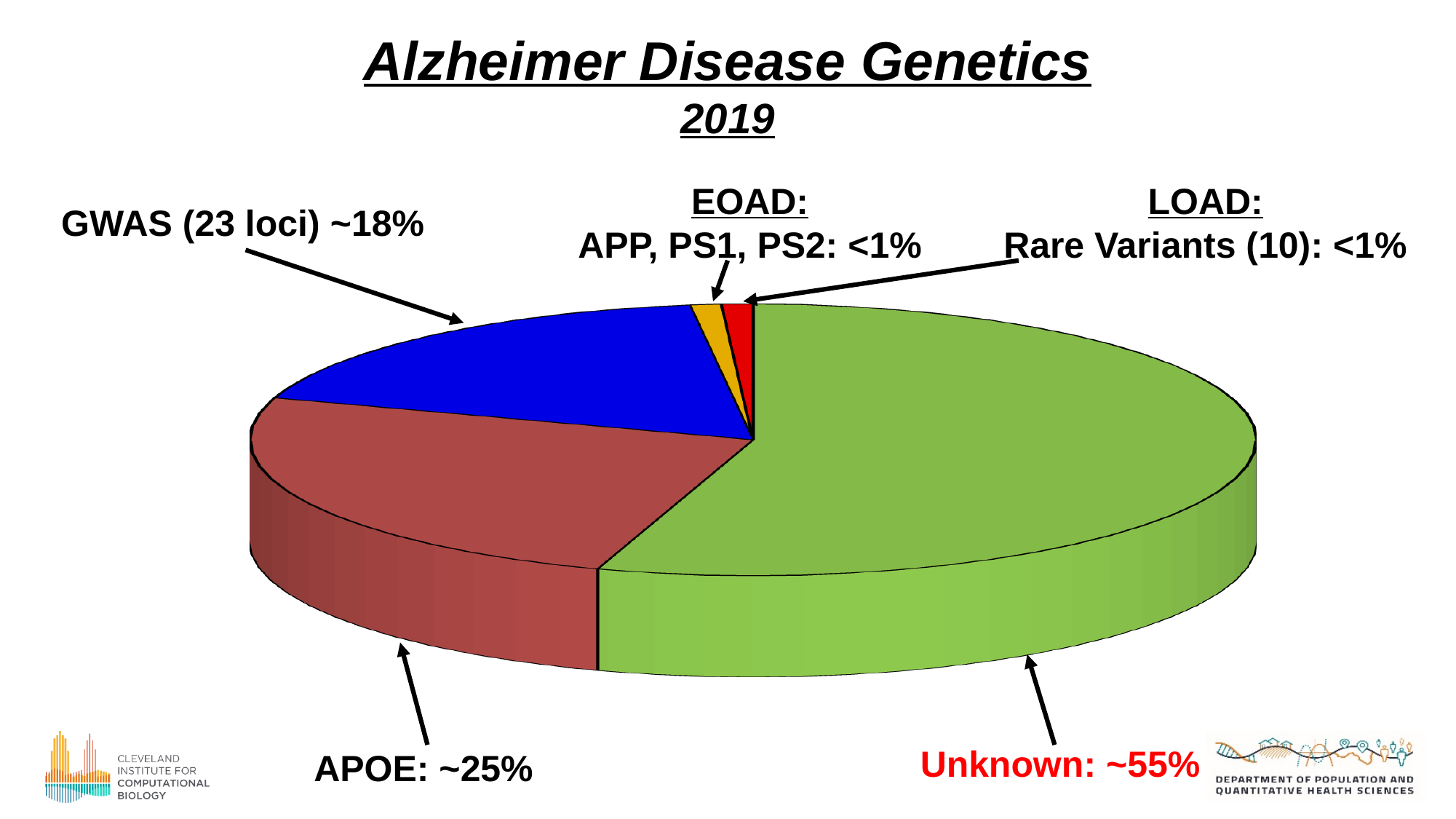
What share is given for EOAD: APP, PS1, PS2? <1% Which slice of the pie is the largest? Unknown What share of the pie is labelled for APOE? ~25% What share is given for LOAD: Rare Variants (10)? <1% What colour is the Unknown slice of the pie? green What share of the pie is labelled for Unknown? ~55% Which is larger, the Unknown slice or the APOE slice? Unknown What is the title of the slide containing the pie chart? Alzheimer Disease Genetics 2019 How many slices does the pie chart have? 5 What kind of chart is shown on the slide? pie chart Which is larger, the APOE slice or the GWAS (23 loci) slice? APOE What share of the pie is labelled for GWAS (23 loci)? ~18%